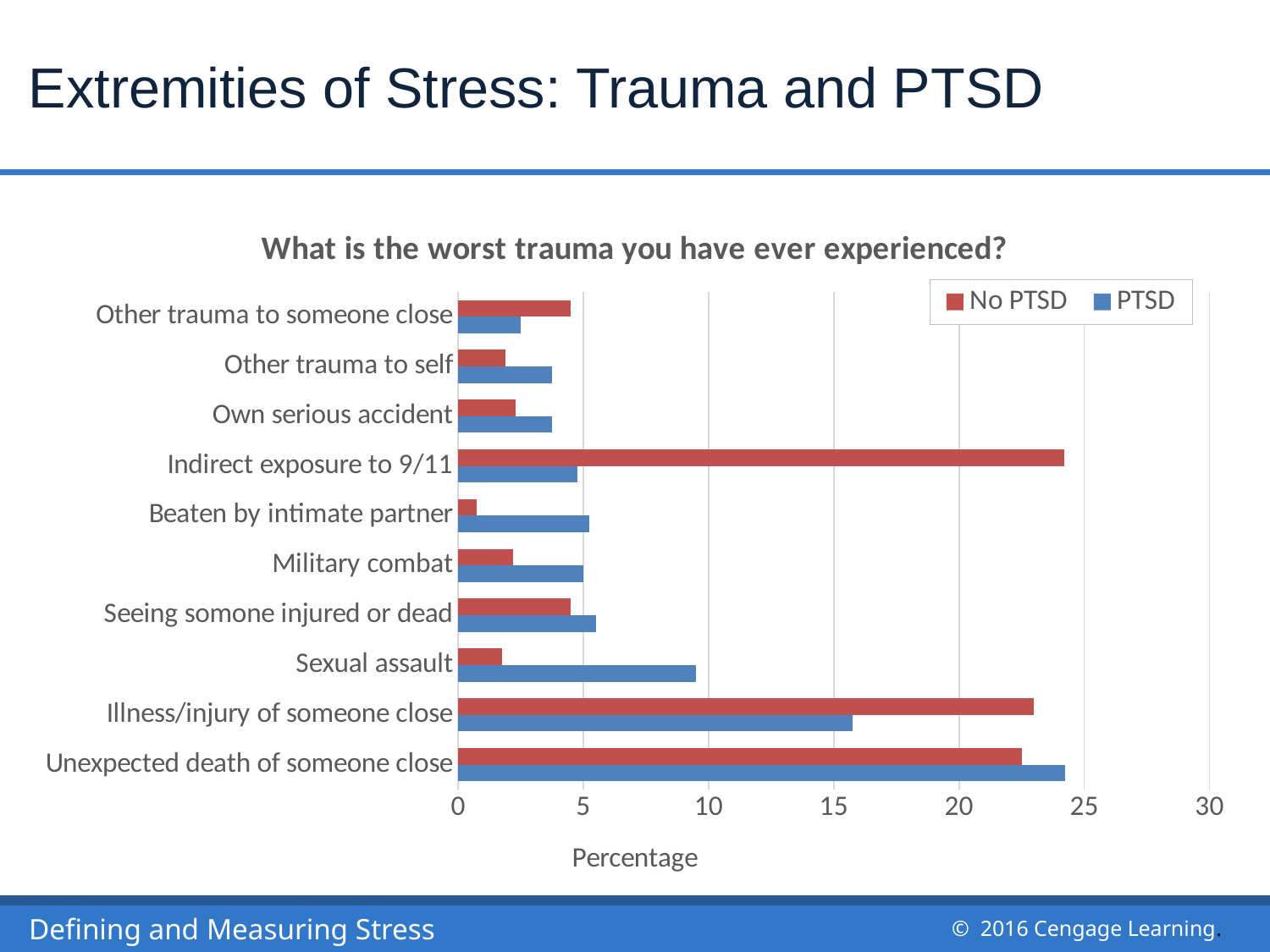
What type of chart is shown on the slide? Bar chart Is the PTSD value for Sexual assault greater or less than 5? greater What is the label on the horizontal axis of the chart? Percentage What is the title of the chart? What is the worst trauma you have ever experienced? Which category has the highest PTSD value? Unexpected death of someone close Is the PTSD value for Illness/injury of someone close greater or less than 10? greater How many series does the legend list? 2 Is the No PTSD value for Indirect exposure to 9/11 greater or less than 20? greater For Sexual assault, which series has the larger value, No PTSD or PTSD? PTSD How many trauma categories are plotted on the chart? 10 Which category has the lowest No PTSD value? Beaten by intimate partner For Indirect exposure to 9/11, which series has the larger value, No PTSD or PTSD? No PTSD